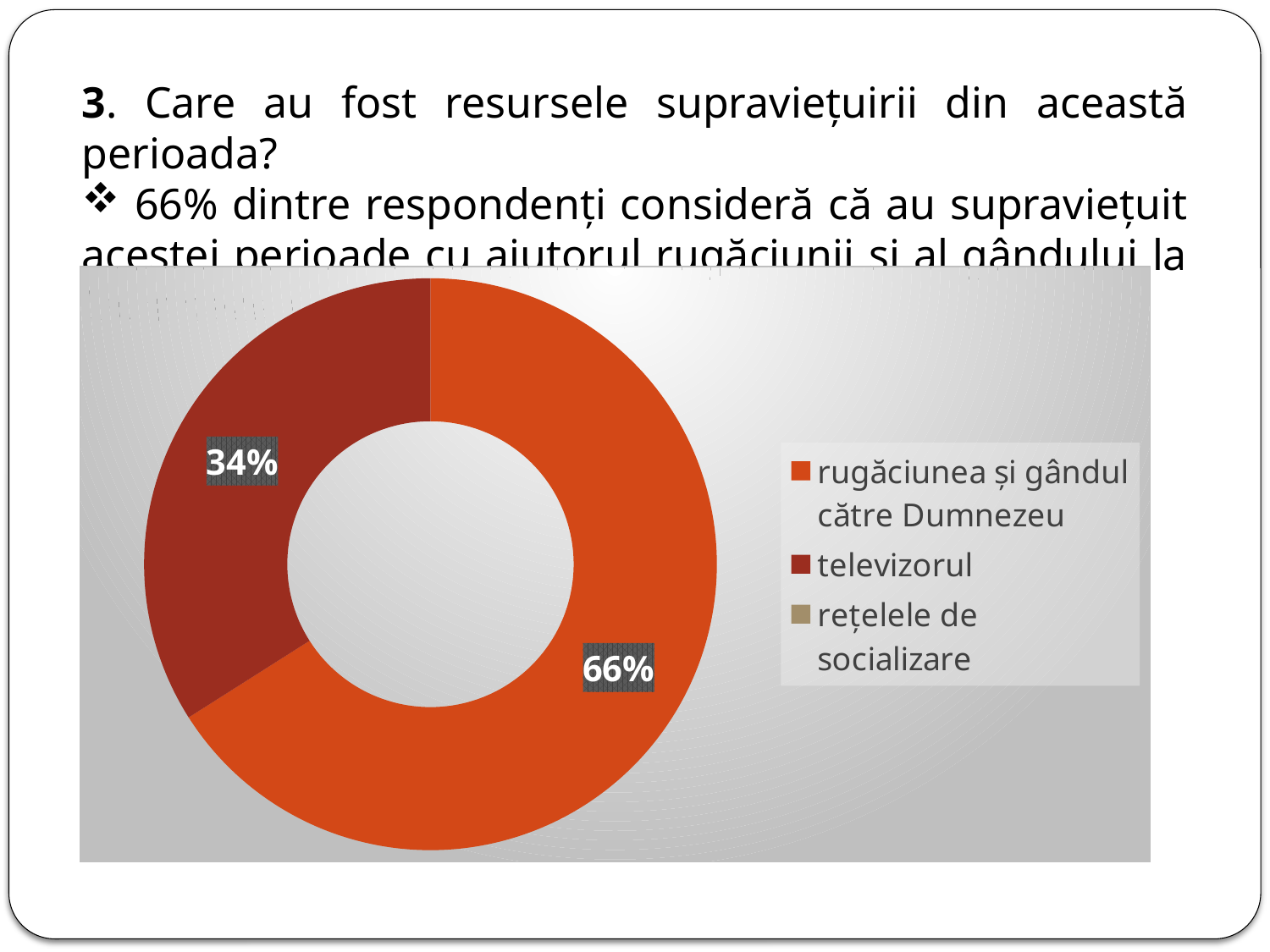
What is the total of the two labelled slices in the chart? 100% What percentage of the chart is labelled for "televizorul"? 34% How many entries does the chart legend list? 3 How many slices have a percentage label printed on the chart? 2 What percentage of the chart is labelled for "rugăciunea și gândul către Dumnezeu"? 66% What colour is the slice for "televizorul"? dark red Which legend entry has no visible slice in the chart? rețelele de socializare Which category has the largest share of the chart? rugăciunea și gândul către Dumnezeu Which of the two labelled slices is larger, "televizorul" or "rugăciunea și gândul către Dumnezeu"? rugăciunea și gândul către Dumnezeu What kind of chart is shown on the slide? doughnut chart What is the difference in percentage points between the "rugăciunea și gândul către Dumnezeu" slice and the "televizorul" slice? 32